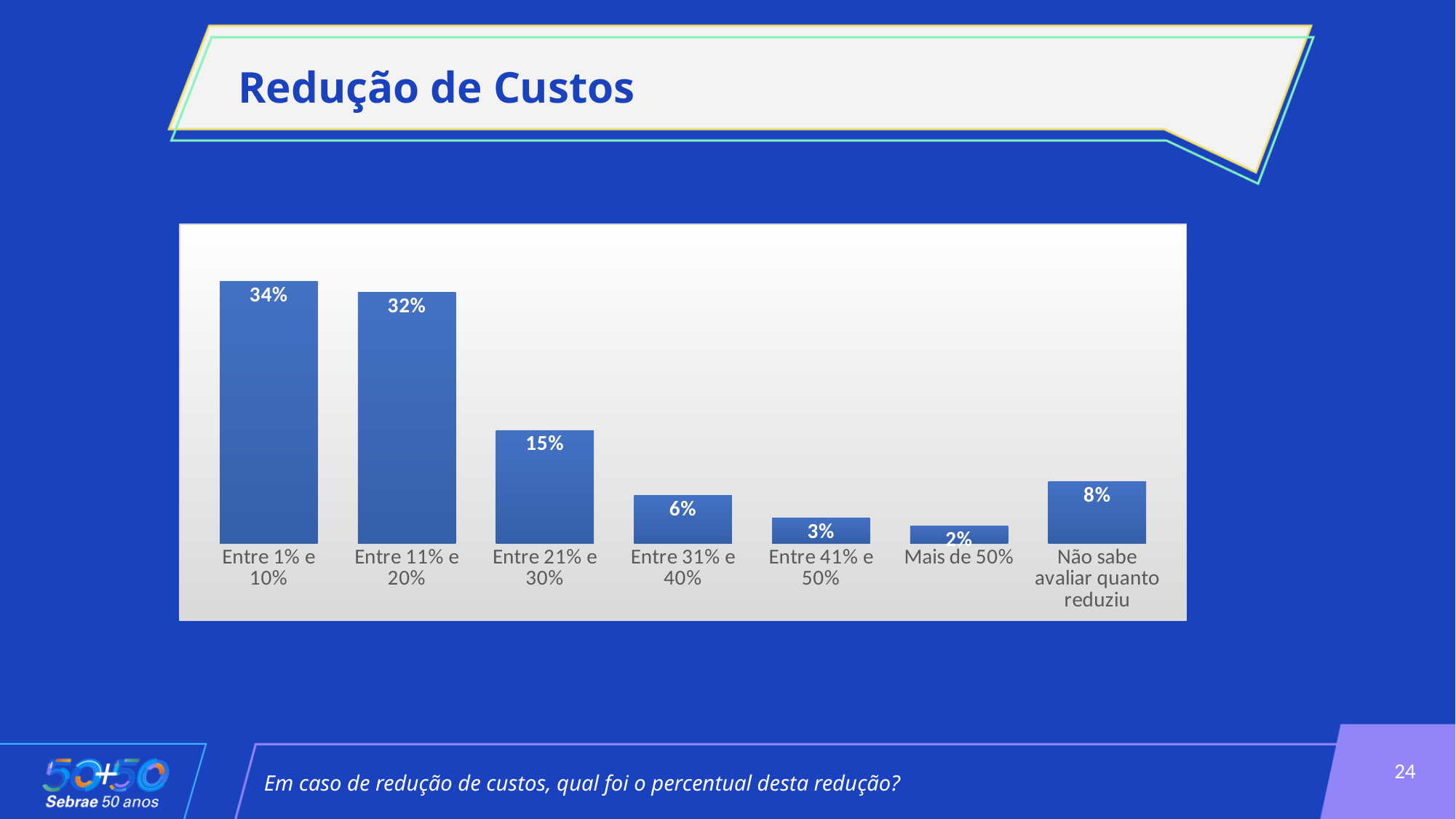
What is the value for the category "Não sabe avaliar quanto reduziu"? 8% How many categories are shown in the chart? 7 What is the value for the category "Entre 1% e 10%"? 34% What is the value for the category "Entre 21% e 30%"? 15% What kind of chart is shown on the slide? Bar chart What is the title of the slide containing the chart? Redução de Custos Which is larger, the value for "Não sabe avaliar quanto reduziu" or the value for "Entre 31% e 40%"? Não sabe avaliar quanto reduziu Which category has the lowest value? Mais de 50% What is the difference between the values for "Entre 21% e 30%" and "Entre 31% e 40%"? 9% What is the value for the category "Mais de 50%"? 2% Which category has the highest value? Entre 1% e 10% What is the difference between the values for "Entre 1% e 10%" and "Entre 11% e 20%"? 2%